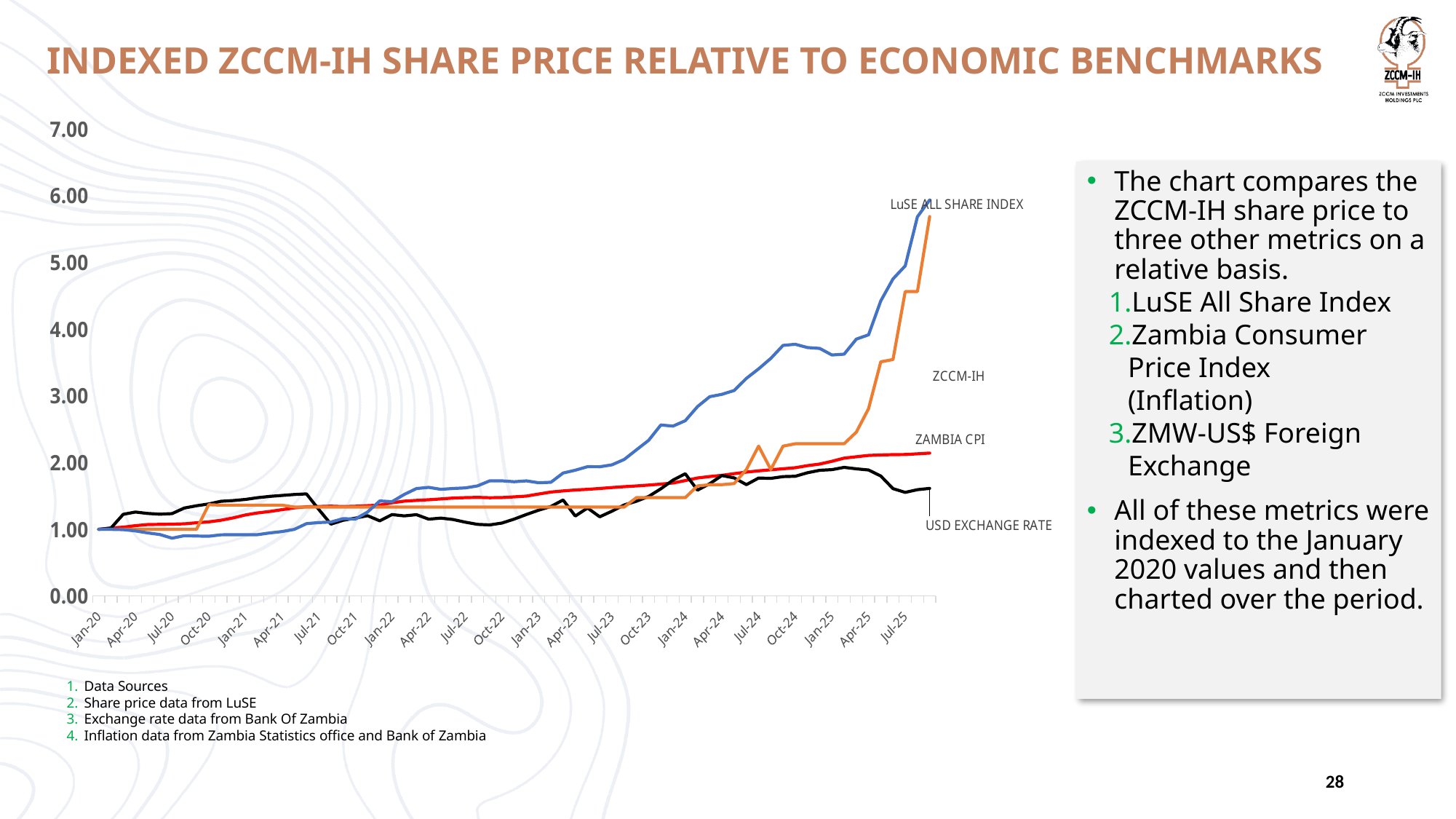
Which series has the lowest value at the end of the period (Jul-25)? USD EXCHANGE RATE Does the LuSE All Share Index generally rise or fall from Jan-22 to Jul-25? rise Which series is drawn as the black line? USD EXCHANGE RATE Is the value of the USD Exchange Rate at the end of the period (Jul-25) greater or less than 2.00? less At the end of the period (Jul-25), which is larger: ZCCM-IH or Zambia CPI? ZCCM-IH Is the value of the LuSE All Share Index at Jan-24 greater or less than 2.00? greater What value do all four series start at in Jan-20? 1.00 What is the title of the chart on the slide? INDEXED ZCCM-IH SHARE PRICE RELATIVE TO ECONOMIC BENCHMARKS How many series are plotted on the chart? 4 What kind of chart is shown on the slide? line chart Is the value of ZCCM-IH at Jul-25 greater or less than 4.00? greater